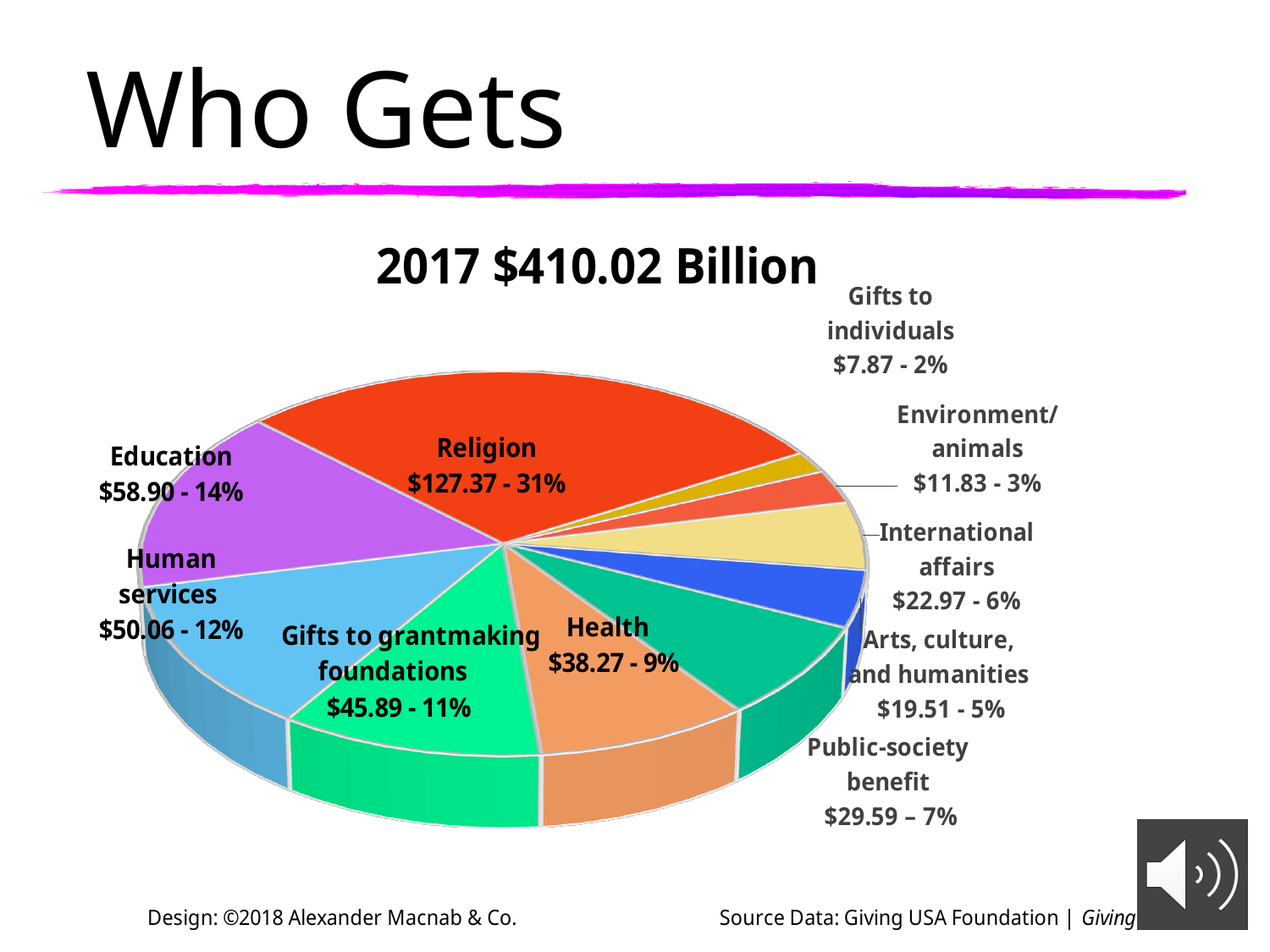
What kind of chart is shown on the slide? pie chart What is the difference between the values for Education and Human services? $8.84 What is the title of the pie chart? 2017 $410.02 Billion Which category has the largest slice of the pie? Religion Which category has the smallest slice of the pie? Gifts to individuals How many categories does the pie chart show? 10 What is the value shown for Environment/animals? $11.83 What is the value shown for Health? $38.27 What share of the pie does Public-society benefit represent? 7% Which is larger, the value for International affairs or the value for Arts, culture, and humanities? International affairs What is the value shown for Religion? $127.37 What share of the pie does Education represent? 14%